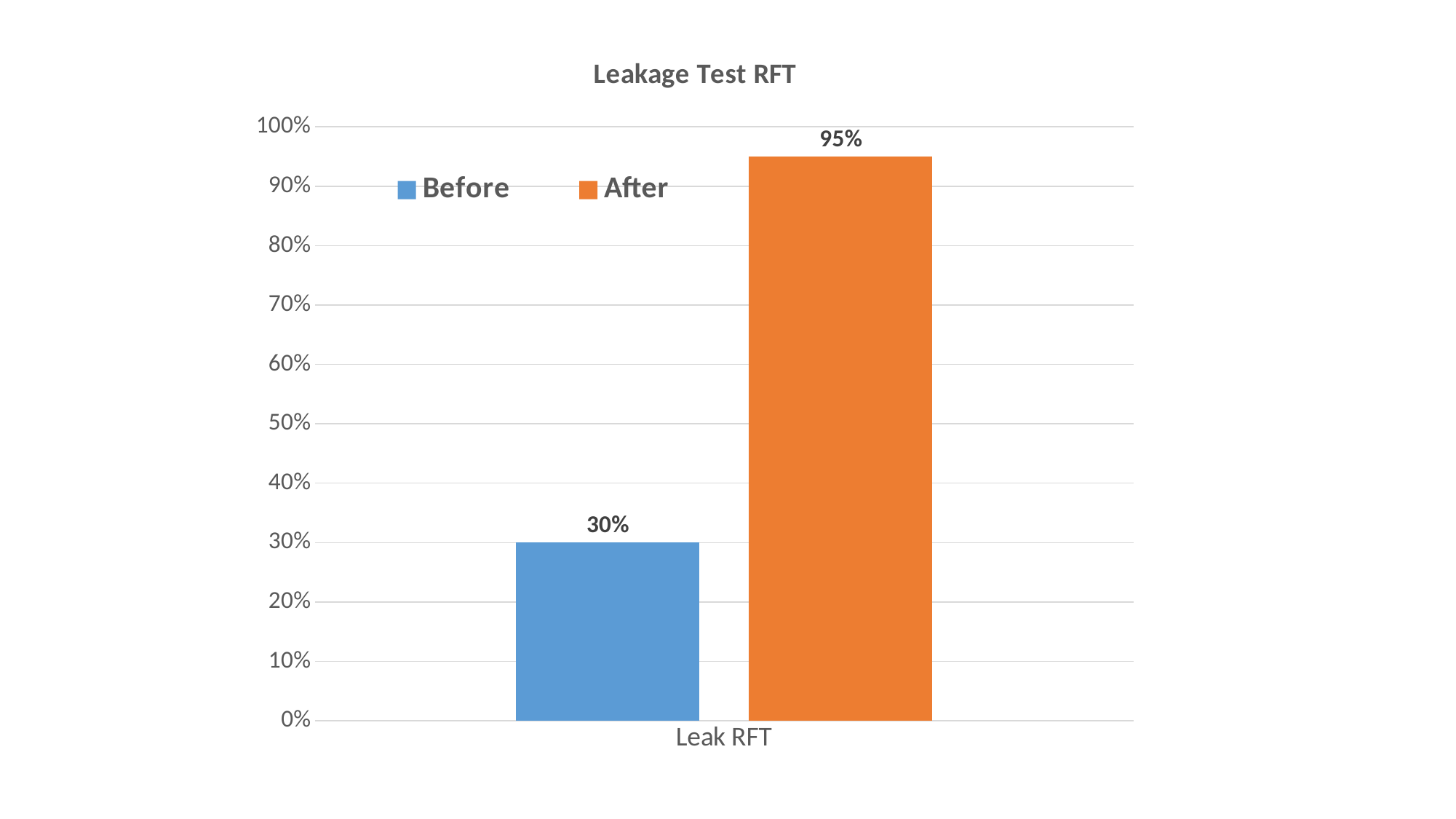
How many series does the legend list? 2 Is the Before value for Leak RFT greater or less than 50%? less Is the After value for Leak RFT greater or less than 90%? greater What is the value of the After series for Leak RFT? 95% What is the value of the Before series for Leak RFT? 30% Which series has the higher value for Leak RFT, Before or After? After What is the title of the chart? Leakage Test RFT What kind of chart is shown on the slide? Bar chart What is the difference between the After and Before values for Leak RFT? 65% How many categories are shown on the x axis? 1 What colour is the After series bar? Orange Which series has the lowest value on the chart? Before